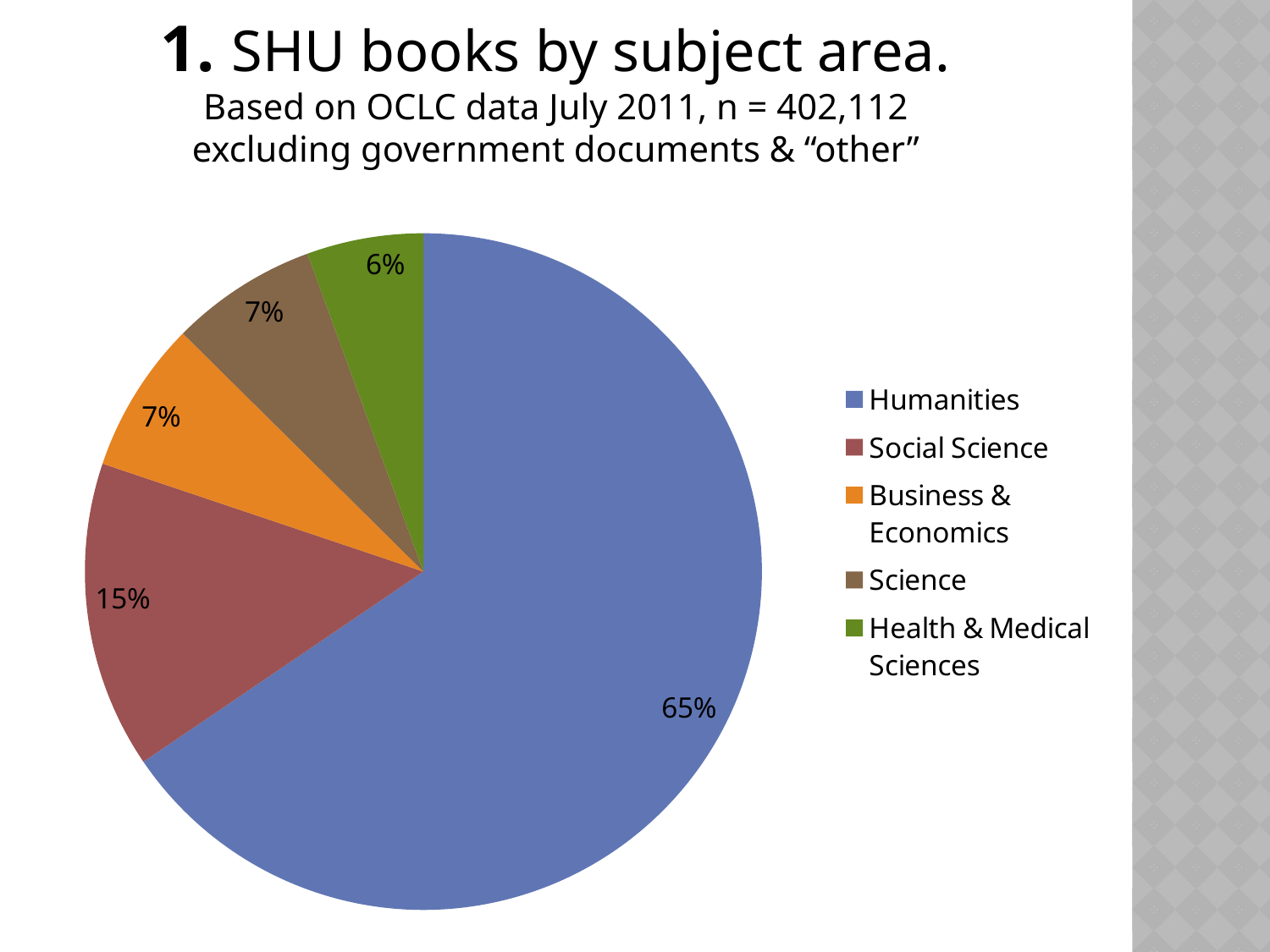
What share of SHU books is in the Humanities? 65% What share of SHU books is in Health & Medical Sciences? 6% What share of SHU books is in Social Science? 15% What kind of chart is shown on the slide? pie chart How many subject areas are shown in the pie chart? 5 What is the combined share of Business & Economics and Science? 14% What is the difference in percentage points between the Humanities share and the Social Science share? 50 Which has a larger share of SHU books, Social Science or Science? Social Science Which subject area has the largest share of SHU books? Humanities Which subject area has the smallest share of SHU books? Health & Medical Sciences According to the subtitle, what is the value of n for the data in the chart? 402,112 What share of SHU books is in Business & Economics? 7%